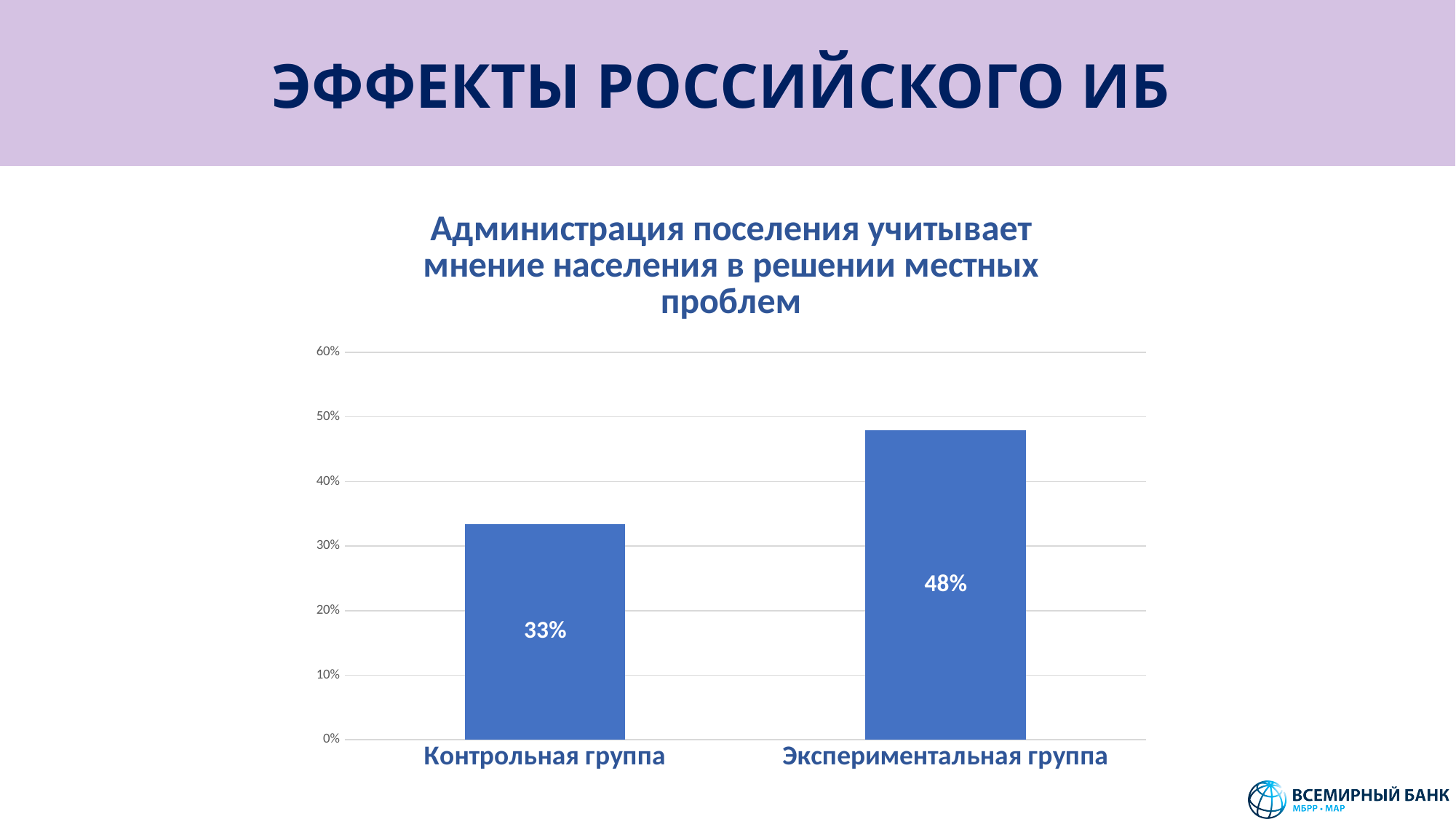
Is the value for Экспериментальная группа greater or less than 40%? greater What is the difference between the values for Экспериментальная группа and Контрольная группа? 15% What kind of chart is shown on the slide? bar chart Is the value for Контрольная группа greater or less than 40%? less How many categories are shown in the chart? 2 Which group has the lower value? Контрольная группа What is the value for Экспериментальная группа? 48% What is the title of the chart? Администрация поселения учитывает мнение населения в решении местных проблем Which is larger: the value for Контрольная группа or the value for Экспериментальная группа? Экспериментальная группа Which group has the higher value? Экспериментальная группа What is the value for Контрольная группа? 33% What is the highest value shown on the vertical axis? 60%